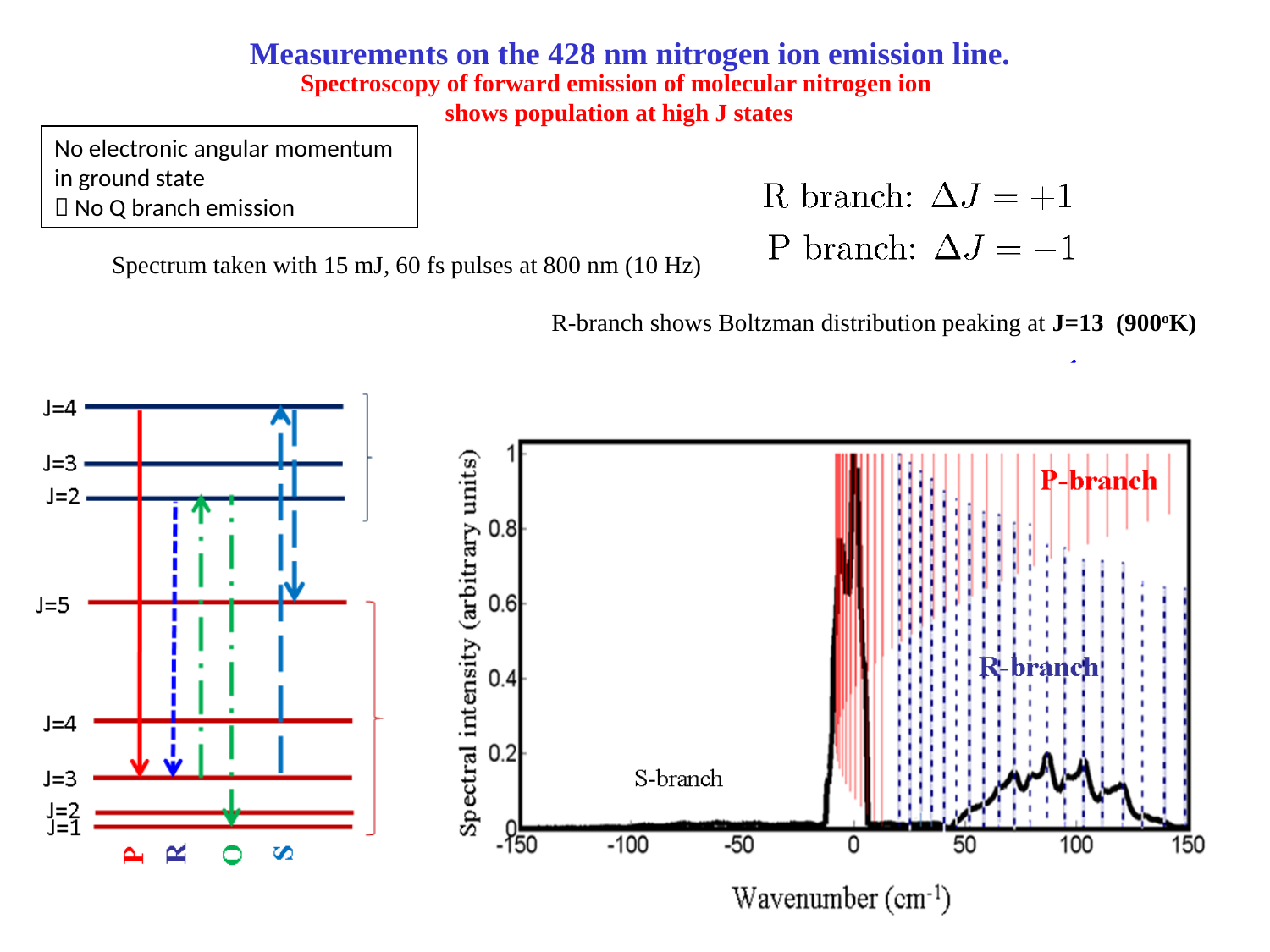
What kind of chart is the spectrum plot on the right of the slide? line chart In the spectrum chart, is the spectral intensity at -100 cm-1 greater or less than 0.2? less In the spectrum chart, which is larger: the spectral intensity at 100 cm-1 or at -100 cm-1? 100 cm-1 In the spectrum chart, is the spectral intensity of the tallest peak near 0 cm-1 greater or less than 0.8? greater In the spectrum chart, does the measured spectral intensity rise or fall as the wavenumber goes from 120 cm-1 to 150 cm-1? fall What is the lowest wavenumber shown on the x axis of the spectrum chart? -150 How many tick labels are shown on the x axis of the spectrum chart? 7 What is the label of the y axis of the spectrum chart? Spectral intensity (arbitrary units) In the spectrum chart, is the spectral intensity of the R-branch peaks near 100 cm-1 greater or less than 0.4? less In the spectrum chart, which is larger: the spectral intensity of the peak near 0 cm-1 or the spectral intensity of the R-branch peaks near 100 cm-1? the peak near 0 cm-1 What is the label of the x axis of the spectrum chart? Wavenumber (cm-1) What is the highest value shown on the y axis of the spectrum chart? 1